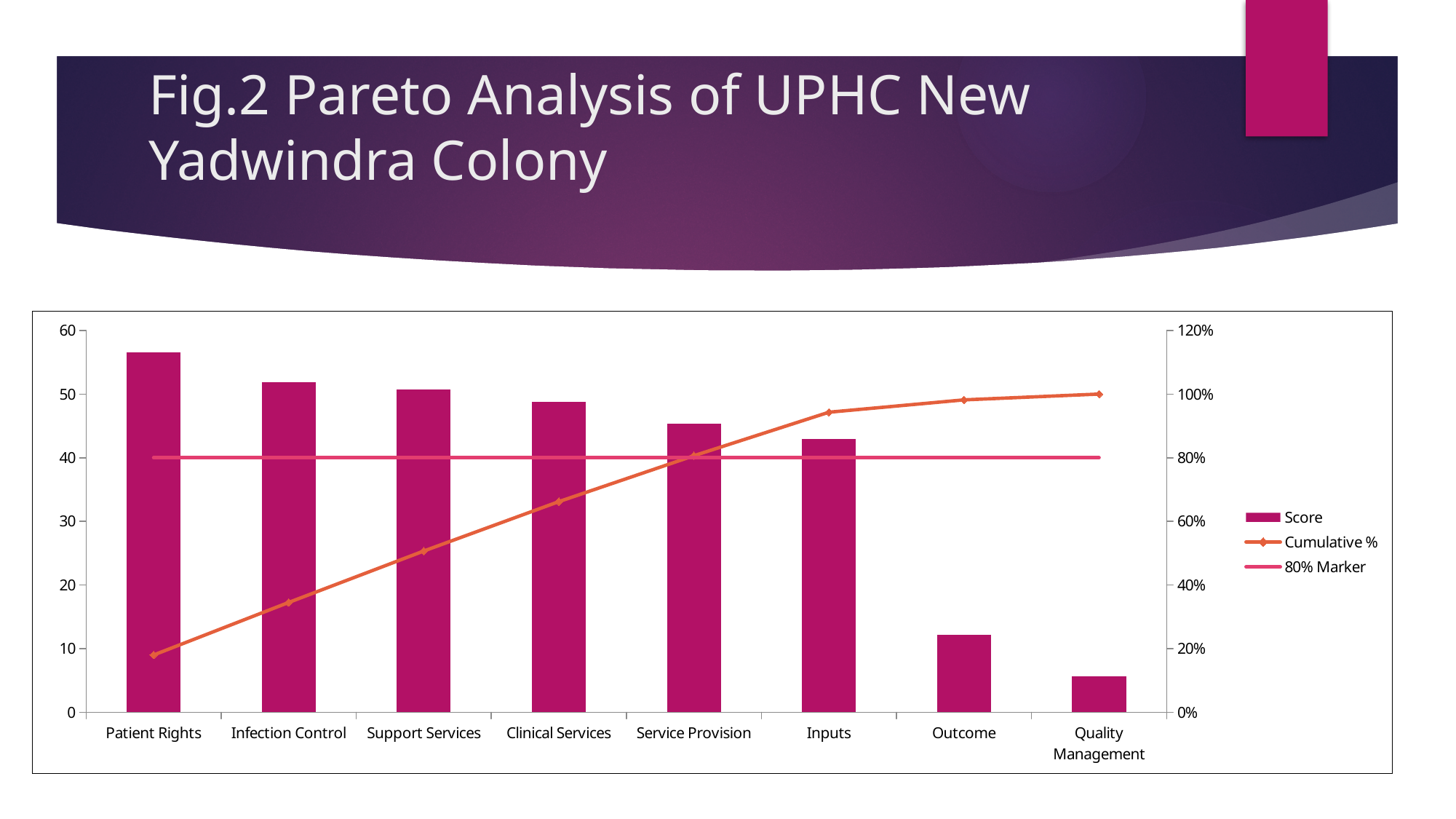
How many categories are shown on the x axis? 8 Is the Score for Quality Management greater or less than 10? less At what percentage level is the 80% Marker line drawn on the right axis? 80% Is the Score for Inputs greater or less than 40? greater Which category has the lowest Score bar? Quality Management Do the Score bars rise or fall from left to right along the x axis? fall Which has a larger Score, Patient Rights or Outcome? Patient Rights Is the Score for Patient Rights greater or less than 50? greater Which category has the highest Score bar? Patient Rights How many series does the legend list? 3